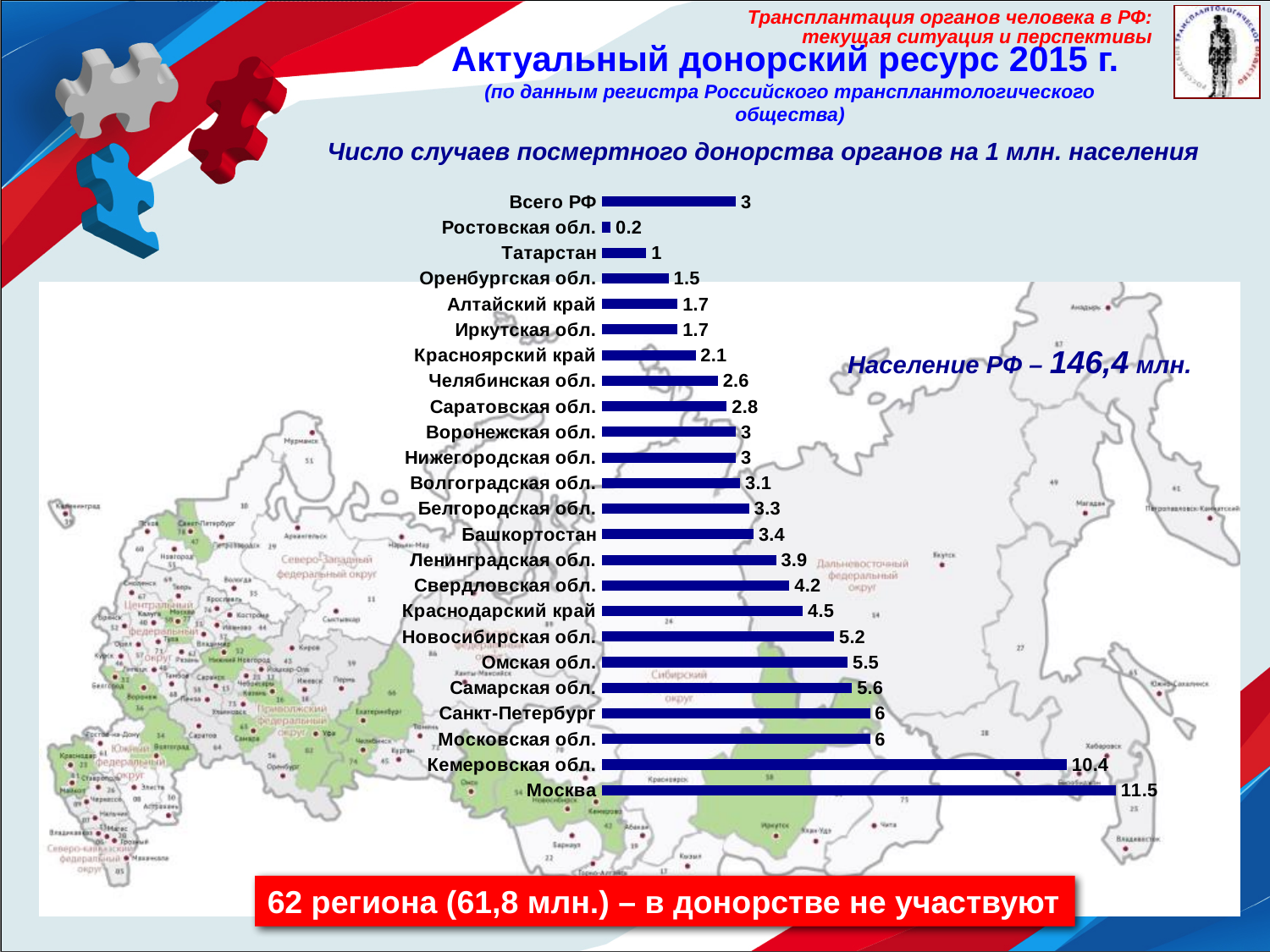
What is the difference between the values for Санкт-Петербург and Самарская обл.? 0.4 How many categories (bars) are shown in the chart? 24 What is the value shown for Всего РФ? 3 Which has a larger value, Свердловская обл. or Краснодарский край? Краснодарский край Which category has the lowest value in the chart? Ростовская обл. What is the difference between the values for Москва and Кемеровская обл.? 1.1 Which category has the highest value in the chart? Москва What is the title of the chart? Число случаев посмертного донорства органов на 1 млн. населения What type of chart is shown on the slide? Bar chart What is the value for Москва in the chart? 11.5 What is the value for Ростовская обл.? 0.2 What is the value for Кемеровская обл.? 10.4